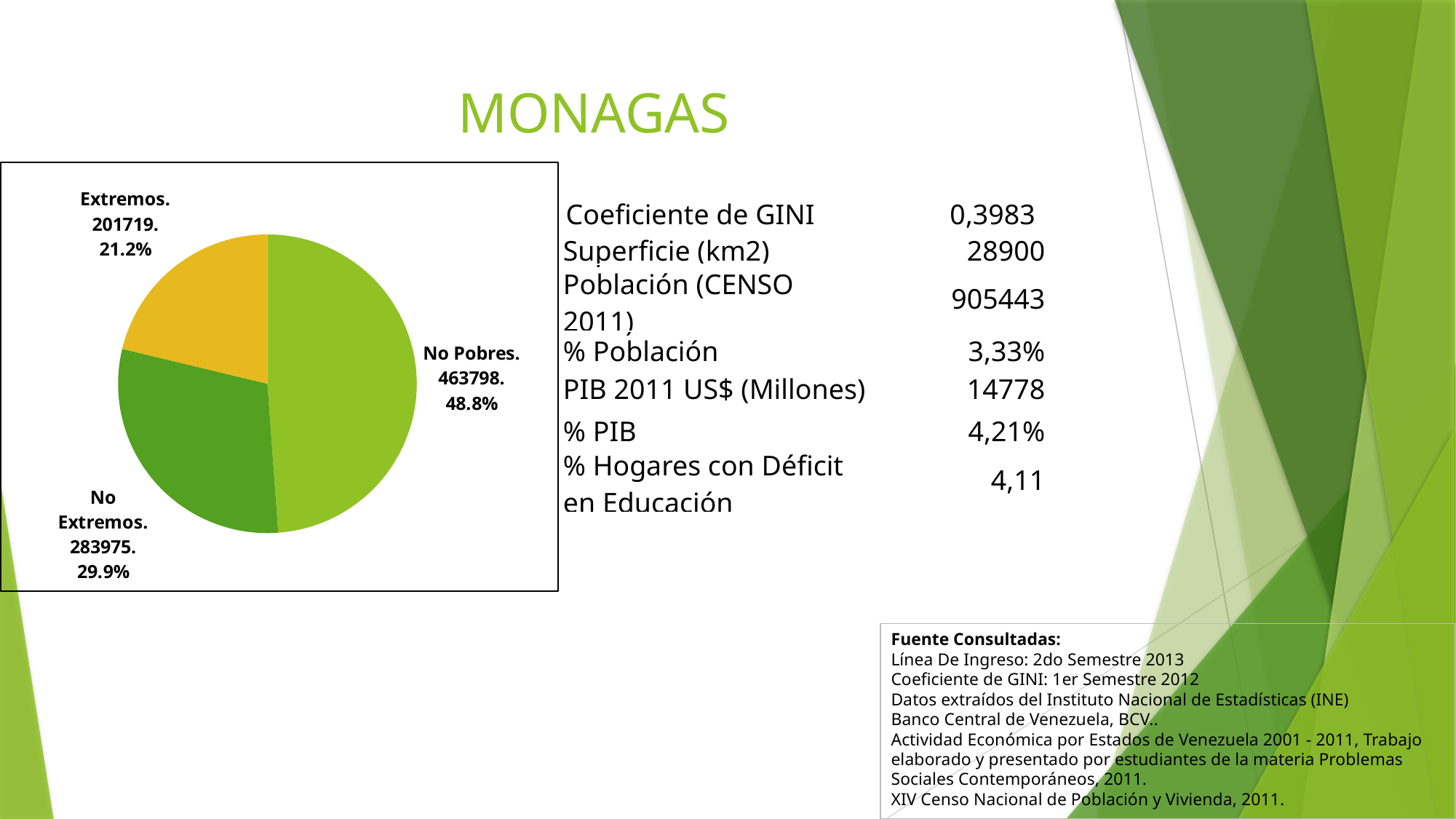
What is the difference between the values for No Extremos and Extremos in the pie chart? 82256 Which category has the largest slice in the pie chart? No Pobres What is the value for Extremos in the pie chart? 201719 What is the value for No Extremos in the pie chart? 283975 How many slices does the pie chart have? 3 What kind of chart is shown on the slide? pie chart Which category has the smallest slice in the pie chart? Extremos What is the value for No Pobres in the pie chart? 463798 Which is larger in the pie chart, No Extremos or Extremos? No Extremos What share of the pie does the No Pobres slice represent? 48.8% What colour is the Extremos slice in the pie chart? yellow What share of the pie does the Extremos slice represent? 21.2%